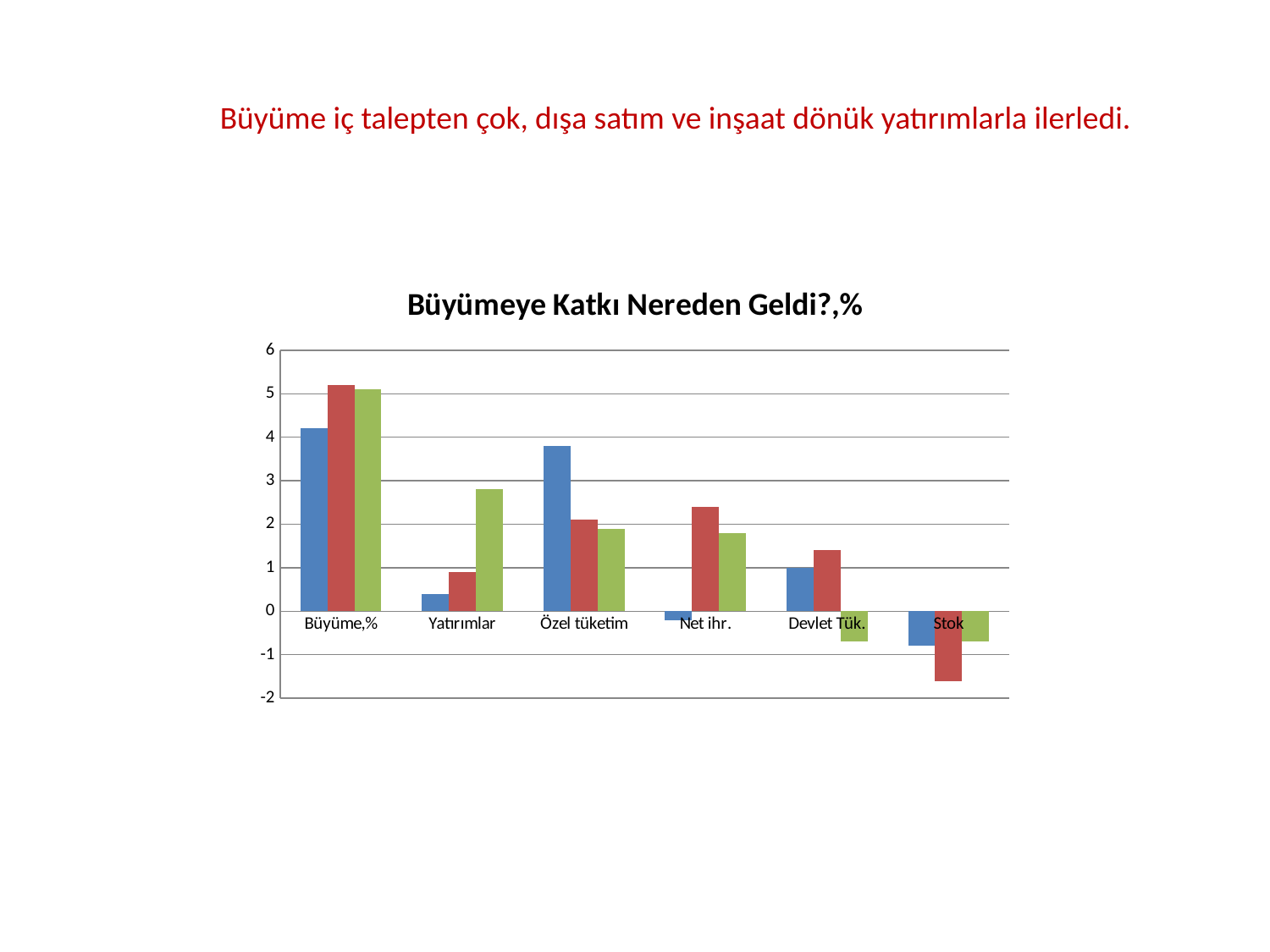
Which category has the highest blue bar? Büyüme,% How many categories are shown on the x axis of the chart? 6 Is the value of the green bar for Yatırımlar greater or less than 2? greater For Net ihr., which bar is larger, the red one or the green one? red Is the value of the red bar for Stok greater or less than -1? less Is the value of the red bar for Büyüme,% greater or less than 5? greater What kind of chart is shown on the slide? bar chart What is the title of the chart? Büyümeye Katkı Nereden Geldi?,% How many bars are plotted for each category in the chart? 3 Which category has the lowest red bar? Stok